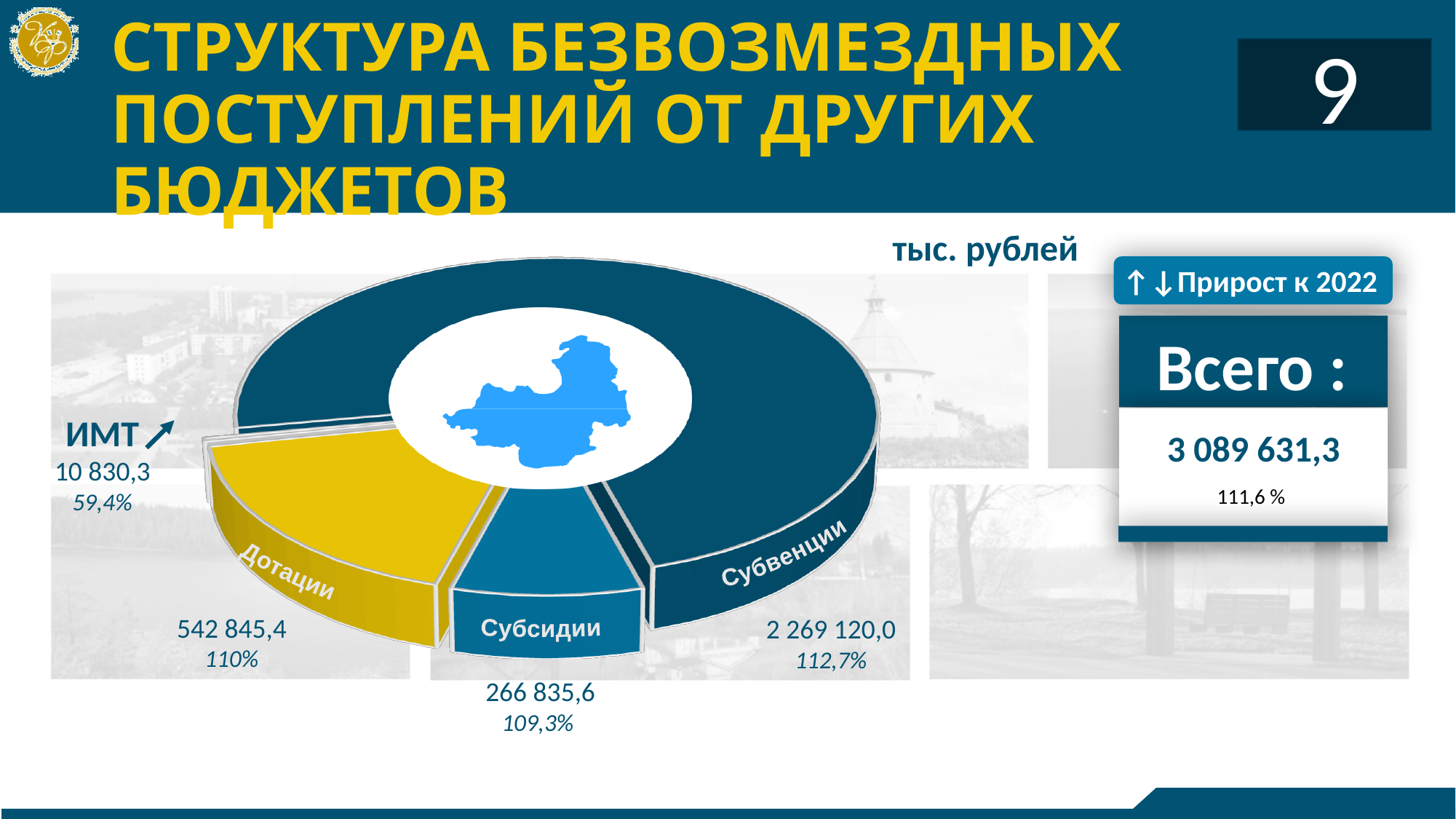
What is the difference between the values for Субвенции and Дотации? 1 726 274,6 How many segments does the pie chart have? 4 Which is larger, Дотации or Субсидии? Дотации What kind of chart is shown on the slide? Pie chart What growth percentage relative to 2022 is shown for Субсидии? 109,3% Which segment of the pie chart has the largest value? Субвенции What is the value for Дотации? 542 845,4 What is the value for ИМТ? 10 830,3 What is the value for Субвенции? 2 269 120,0 What is the value for Субсидии? 266 835,6 Which segment of the pie chart has the smallest value? ИМТ What total (Всего) is shown on the slide? 3 089 631,3